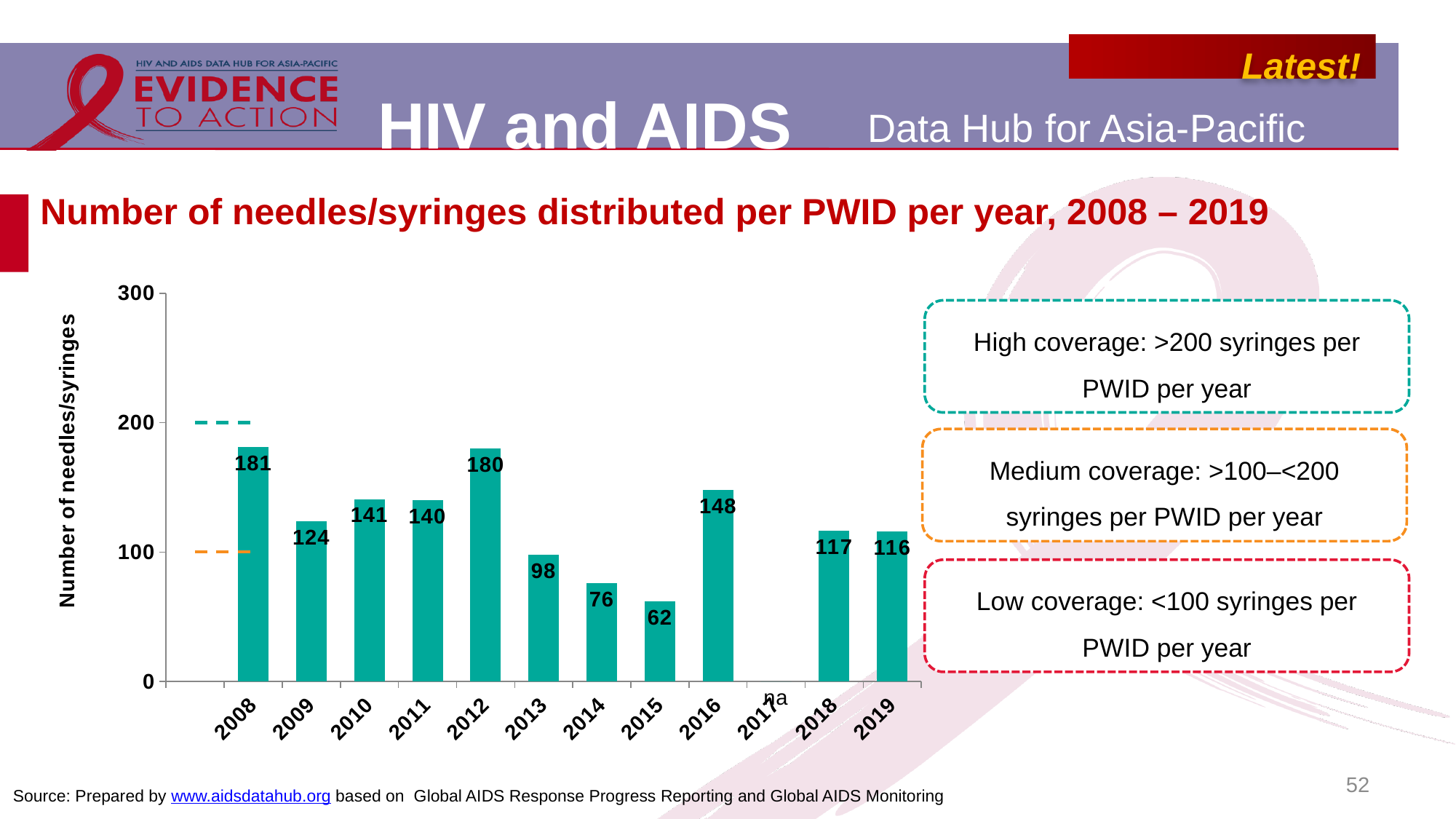
What is the difference between the values for 2008 and 2019? 65 Which year has the lowest number of needles/syringes distributed per PWID? 2015 Which is larger, the value for 2009 or the value for 2018? 2009 What value is shown for 2016? 148 How many years are shown on the x axis? 12 What kind of chart is shown on the slide? bar chart Which year has the highest number of needles/syringes distributed per PWID? 2008 Do the values rise or fall from 2012 to 2015? fall What is the difference between the values for 2012 and 2013? 82 What value is shown for 2019? 116 What is the number of needles/syringes distributed per PWID in 2008? 181 Is the value for 2014 greater or less than 100? less